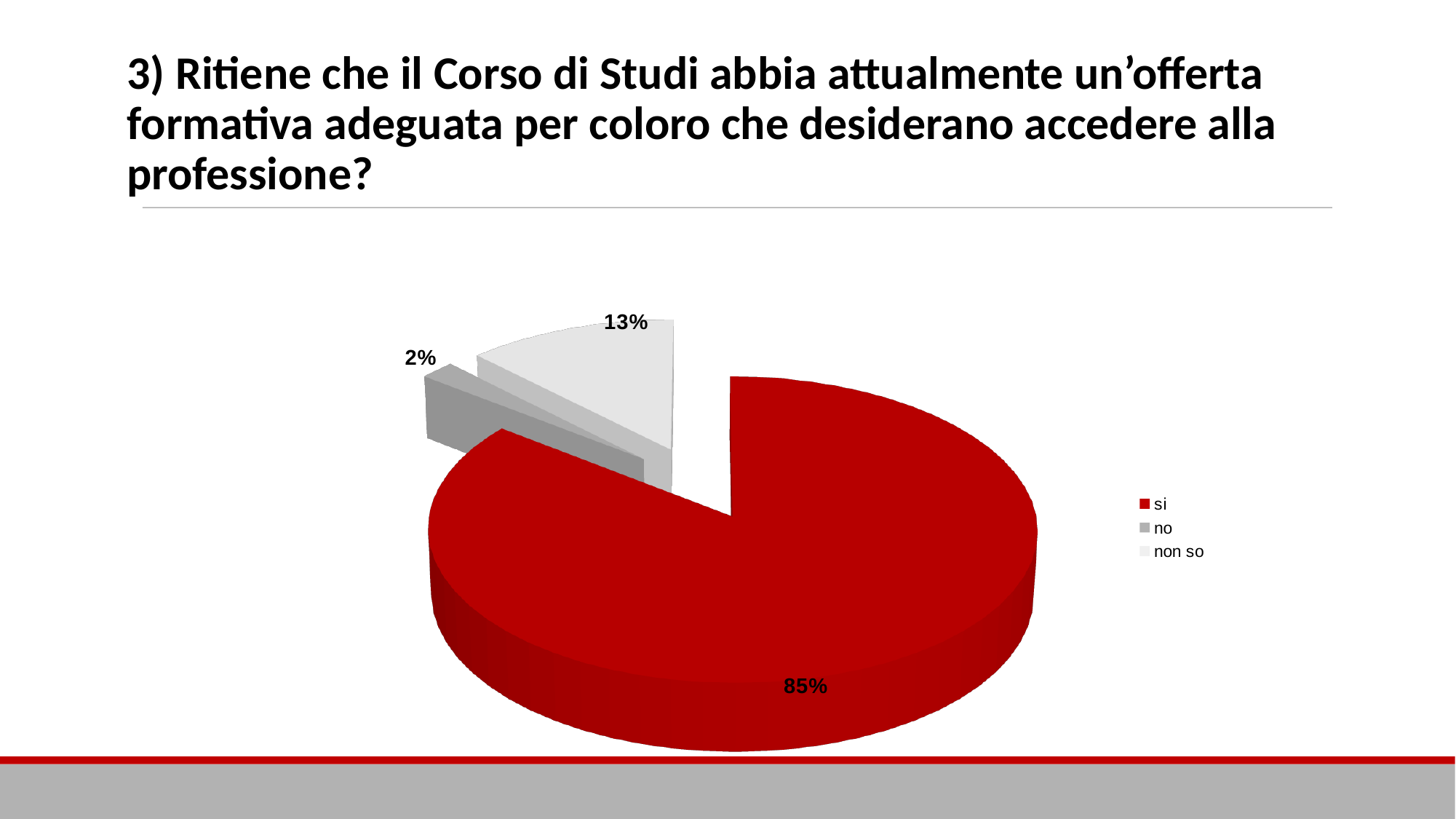
What kind of chart is shown on the slide? pie chart What colour is the "si" slice? red How many slices does the pie chart have? 3 Which slice is larger, "no" or "non so"? non so What percentage of respondents answered "si"? 85% How many entries does the legend list? 3 Which response has the smallest share of the pie? no What is the difference in percentage points between the "si" and "non so" slices? 72 What is the difference in percentage points between the "non so" and "no" slices? 11 Which response has the largest share of the pie? si What percentage of respondents answered "no"? 2% What percentage of respondents answered "non so"? 13%